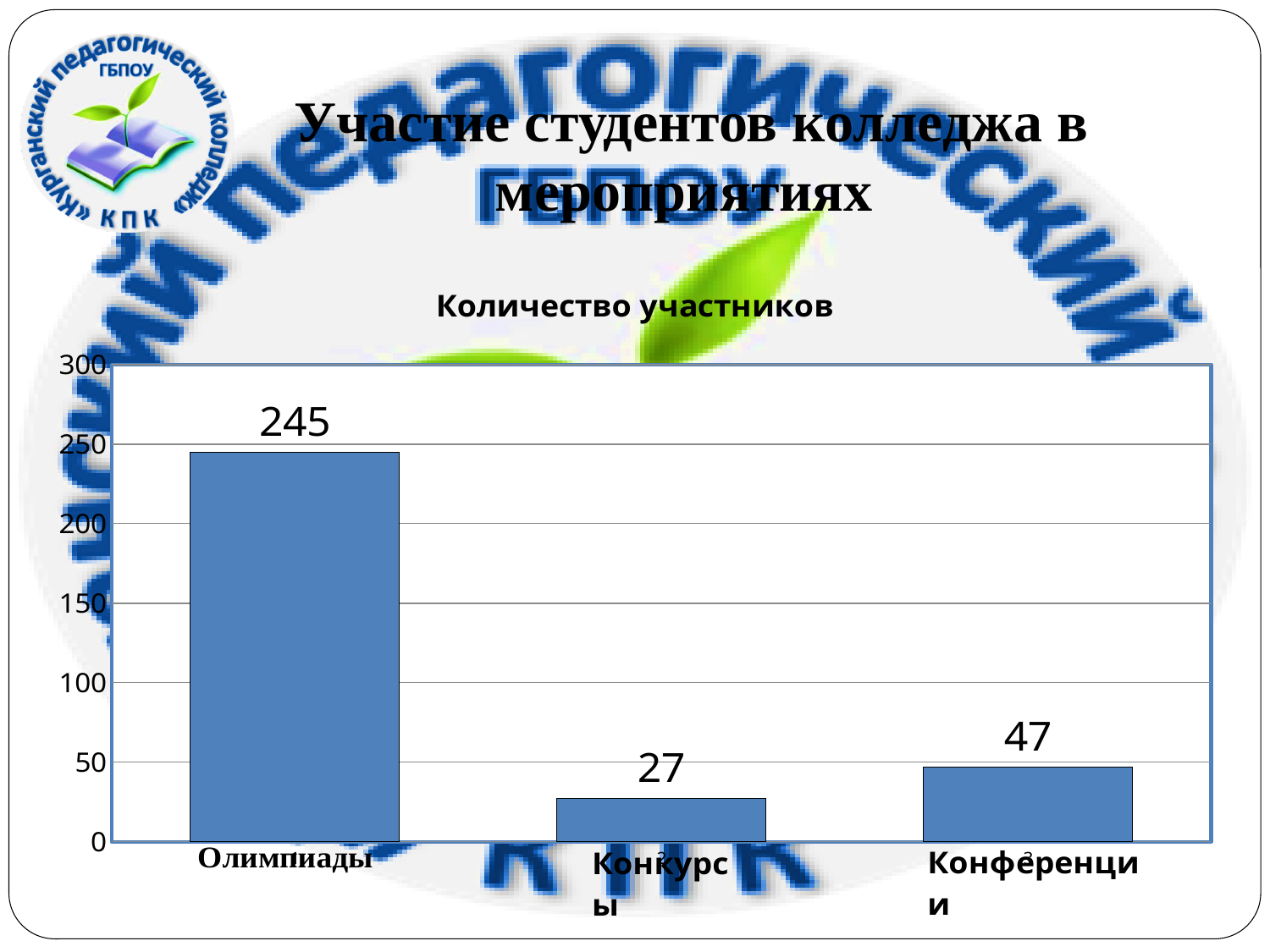
Which is larger, the value for Конкурсы or the value for Конференции? Конференции What is the title of the chart? Количество участников What is the difference between the values for Олимпиады and Конференции? 198 Which category has the highest number of participants? Олимпиады How many categories are shown in the chart? 3 What kind of chart is shown on the slide? bar chart What is the value for Олимпиады? 245 What is the value for Конференции? 47 What is the value for Конкурсы? 27 Which category has the lowest number of participants? Конкурсы Is the value for Олимпиады greater or less than 200? greater What is the difference between the values for Конференции and Конкурсы? 20